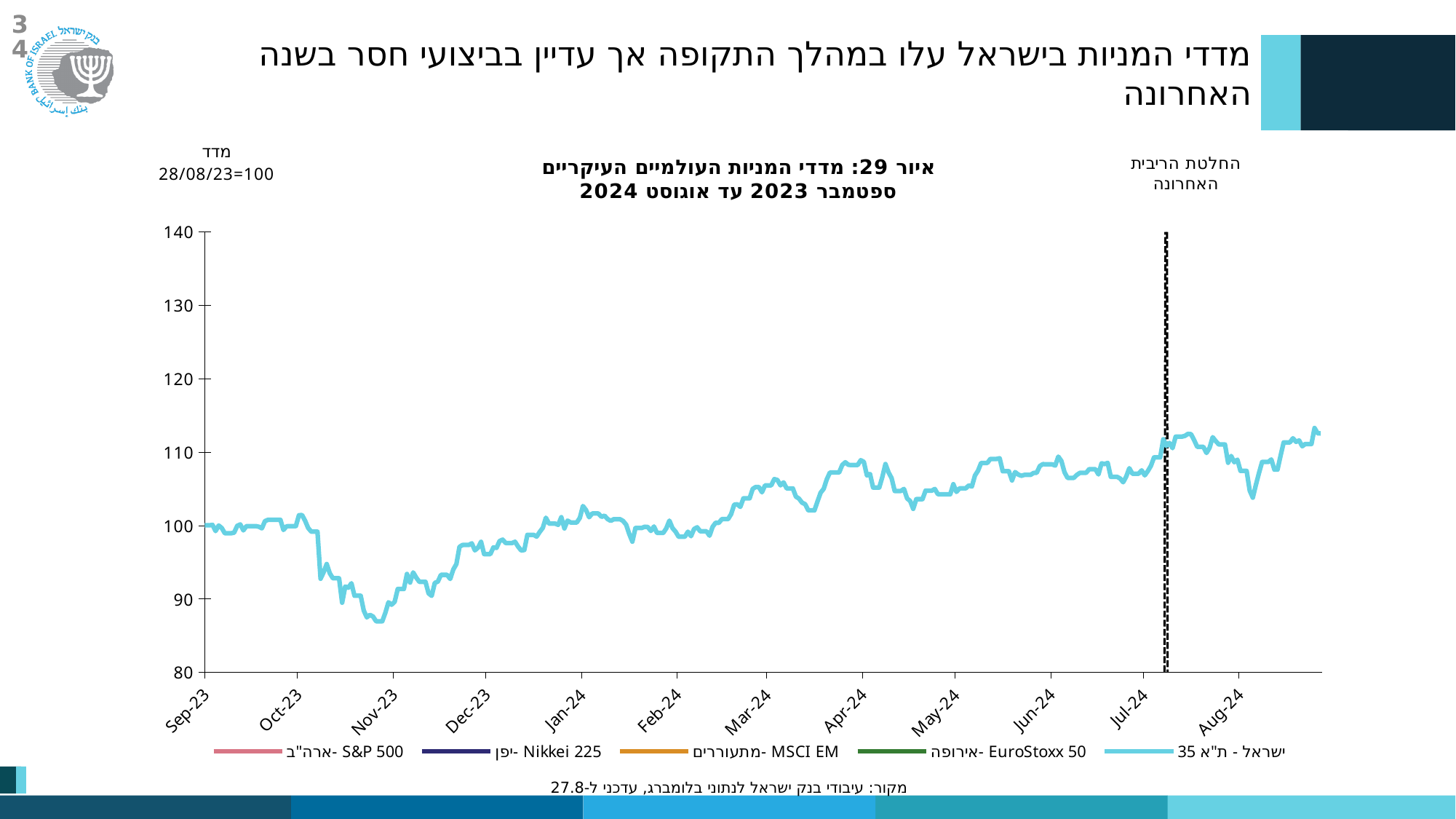
How many series does the legend list? 5 What event does the vertical dashed line in the chart mark, according to its label? החלטת הריבית האחרונה What kind of chart is shown on the slide? line chart Is the value of the TA 35 line at the end of the series in Aug-24 greater or less than 110? greater Is the value of the TA 35 line at its lowest point in Nov-23 greater or less than 90? less Is the value of the TA 35 line at Dec-23 greater or less than 100? less Which is larger for the TA 35 line: the value at Nov-23 or the value at Aug-24? Aug-24 How many month labels are shown on the x axis? 12 Overall, does the TA 35 line rise or fall from Sep-23 to Aug-24? rise Around which month does the plotted TA 35 line reach its lowest point? Nov-23 What base value does the y-axis label state for the index on 28/08/23? 100